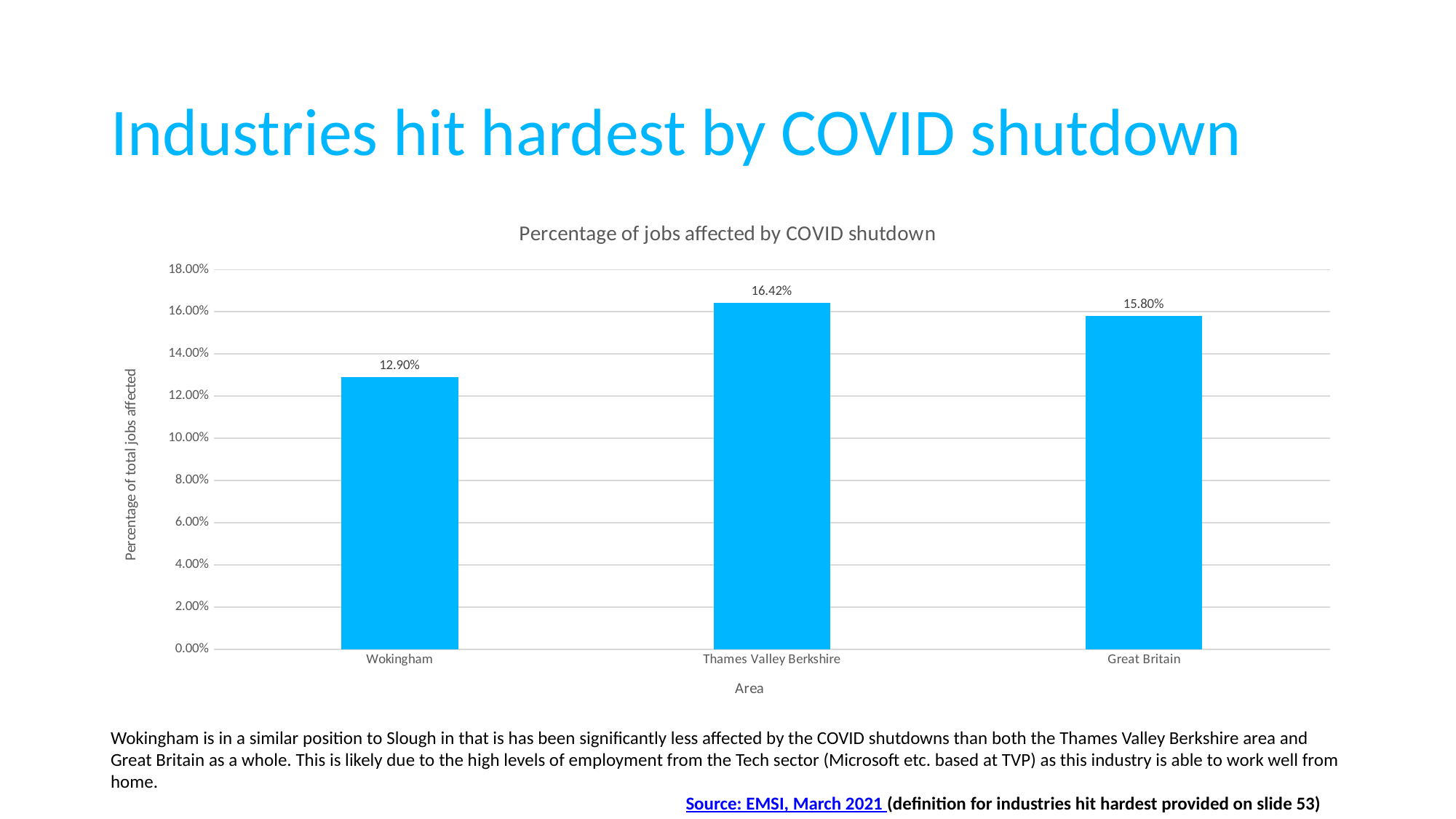
What type of chart is shown on the slide? Bar chart Which area has the highest percentage of jobs affected by COVID shutdown? Thames Valley Berkshire What is the difference in percentage points between Great Britain and Wokingham? 2.90% Which has a higher percentage of jobs affected: Great Britain or Wokingham? Great Britain What is the title of the chart? Percentage of jobs affected by COVID shutdown What is the percentage of jobs affected by COVID shutdown for Great Britain? 15.80% Is the value for Wokingham greater or less than 14.00%? less Which area has the lowest percentage of jobs affected by COVID shutdown? Wokingham What is the percentage of jobs affected by COVID shutdown for Thames Valley Berkshire? 16.42% What is the difference in percentage points between Thames Valley Berkshire and Wokingham? 3.52% What is the percentage of jobs affected by COVID shutdown for Wokingham? 12.90% How many areas are shown in the chart? 3